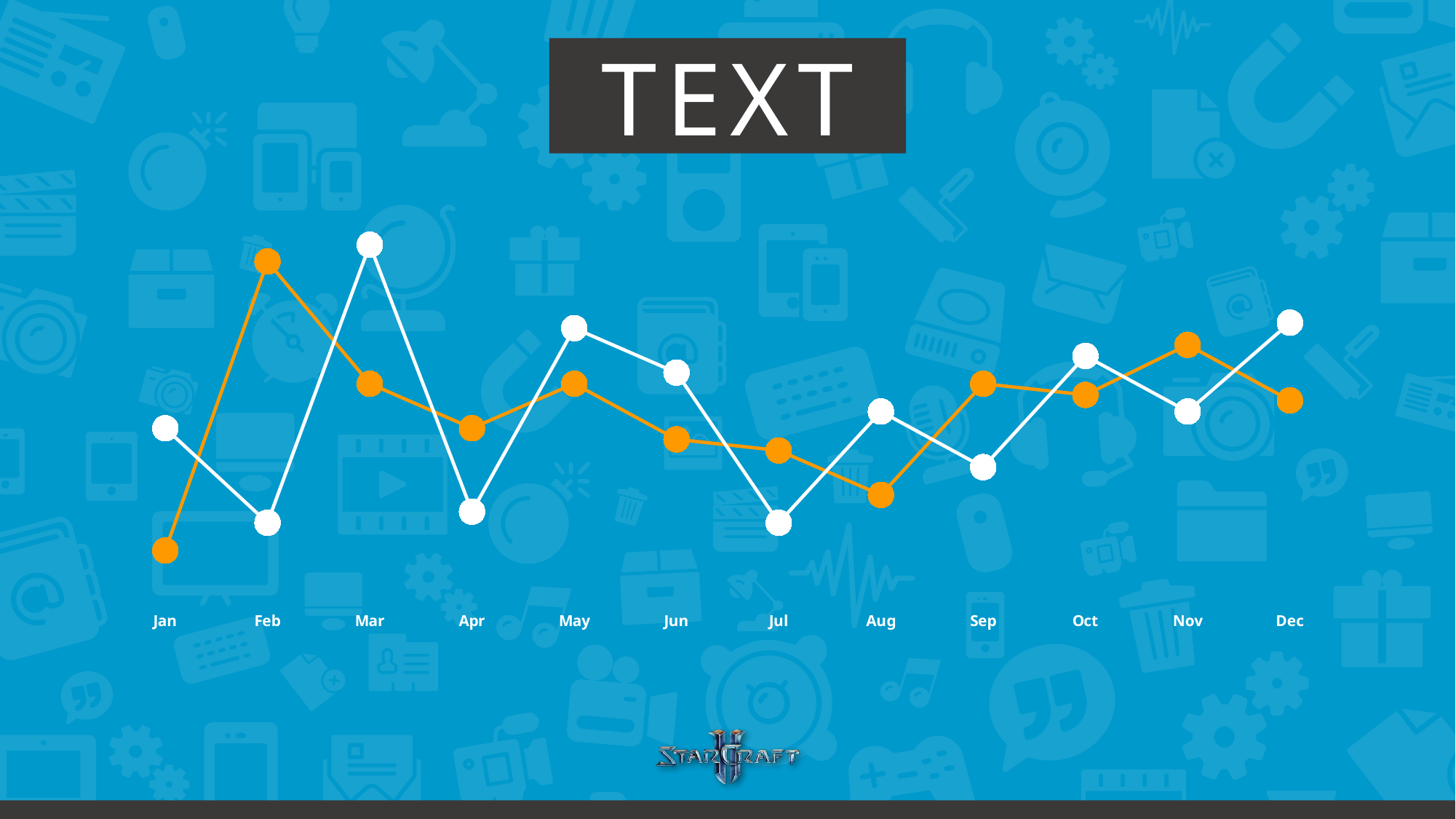
How many months are plotted along the x axis of the chart? 12 In Feb, which line is higher, the orange line or the white line? orange Does the white line rise or fall from Mar to Apr? fall In which month does the orange line reach its lowest point? Jan In Mar, which line is higher, the orange line or the white line? white In Aug, which line is higher, the orange line or the white line? white How many lines (series) are plotted on the chart? 2 What title is shown above the chart? TEXT In which month does the white line reach its highest point? Mar What kind of chart is shown on the slide? line chart In which month does the orange line reach its highest point? Feb Does the orange line rise or fall from May to Aug? fall